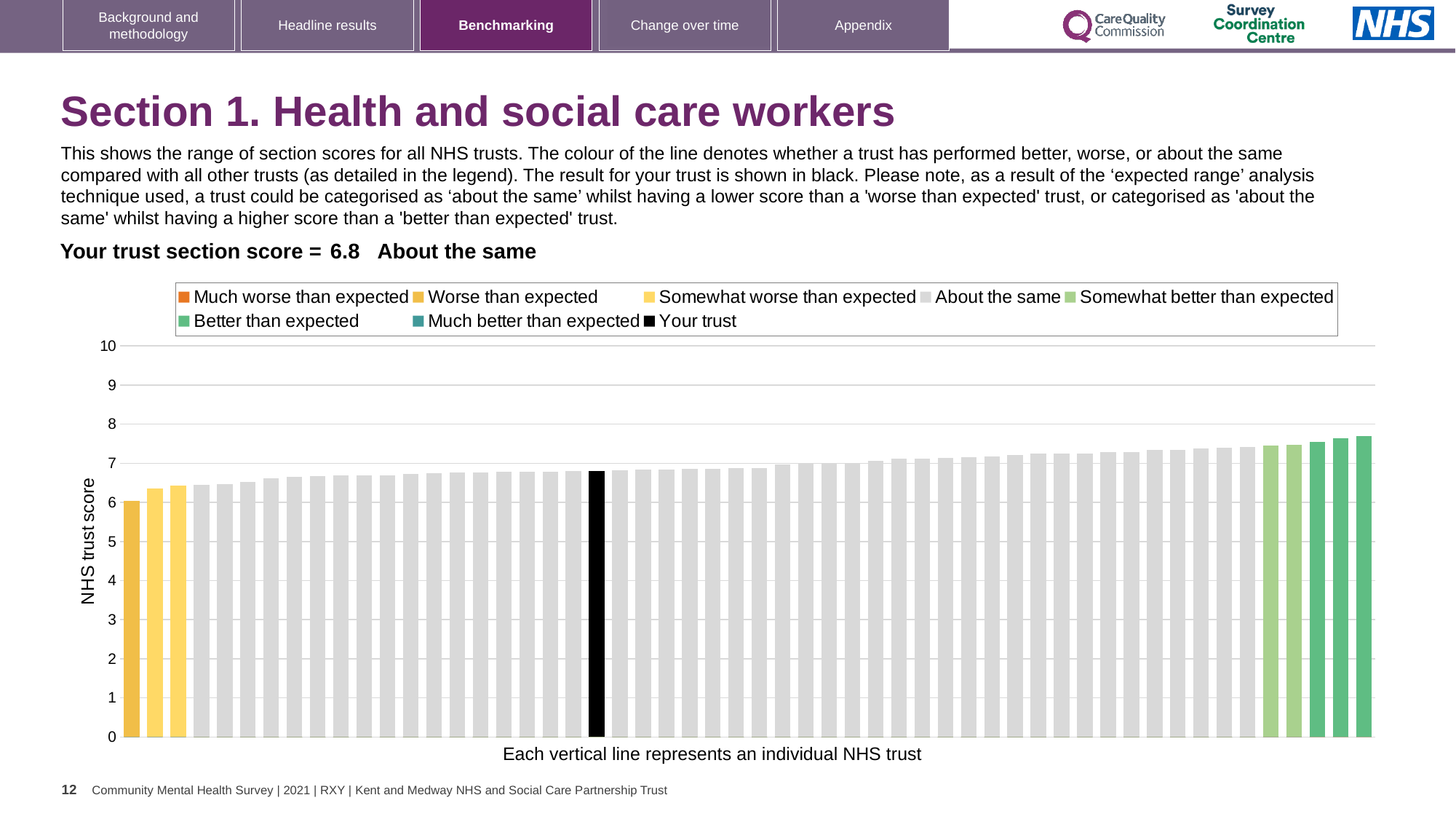
Which legend category does the highest bar in the chart belong to? Better than expected How many entries does the chart legend list? 8 Is the value of the lowest bar in the chart greater or less than 7? less Is the value of the highest bar in the chart greater or less than 8? less Do the bar values rise or fall from left to right across the chart? rise What is the label on the vertical axis of the chart? NHS trust score What is the section score for your trust shown on the slide? 6.8 What colour is the bar representing your trust? black How many bars are coloured as 'Somewhat worse than expected' (yellow)? 2 What kind of chart is shown on the slide? bar chart Which category is your trust's section score placed in? About the same Is the value of the highest bar in the chart greater or less than 7? greater